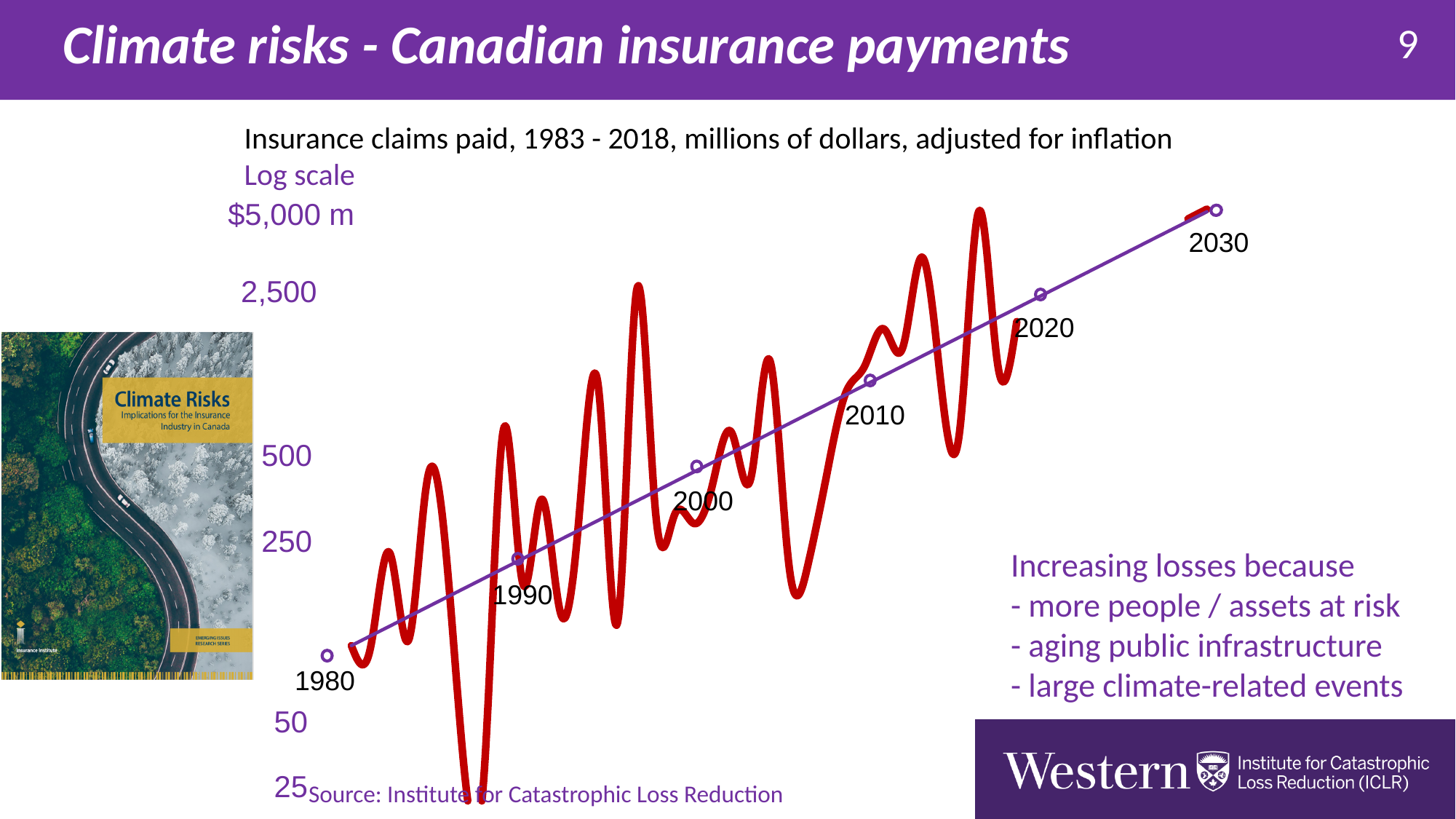
How many year labels are shown along the trend line? 6 What is the title of the chart? Insurance claims paid, 1983 - 2018, millions of dollars, adjusted for inflation What kind of chart is shown on the slide? line chart Is the lowest point of the red claims line greater or less than 50? less Which is larger on the trend line, the value at 2020 or the value at 1990? 2020 What is the highest value labelled on the vertical axis? $5,000 m Is the value of the trend line at 2010 greater or less than 500? greater What kind of scale does the chart's vertical axis use? Log scale Is the value of the trend line at 1980 greater or less than 50? greater Does the purple trend line rise or fall from 1980 to 2030? rise